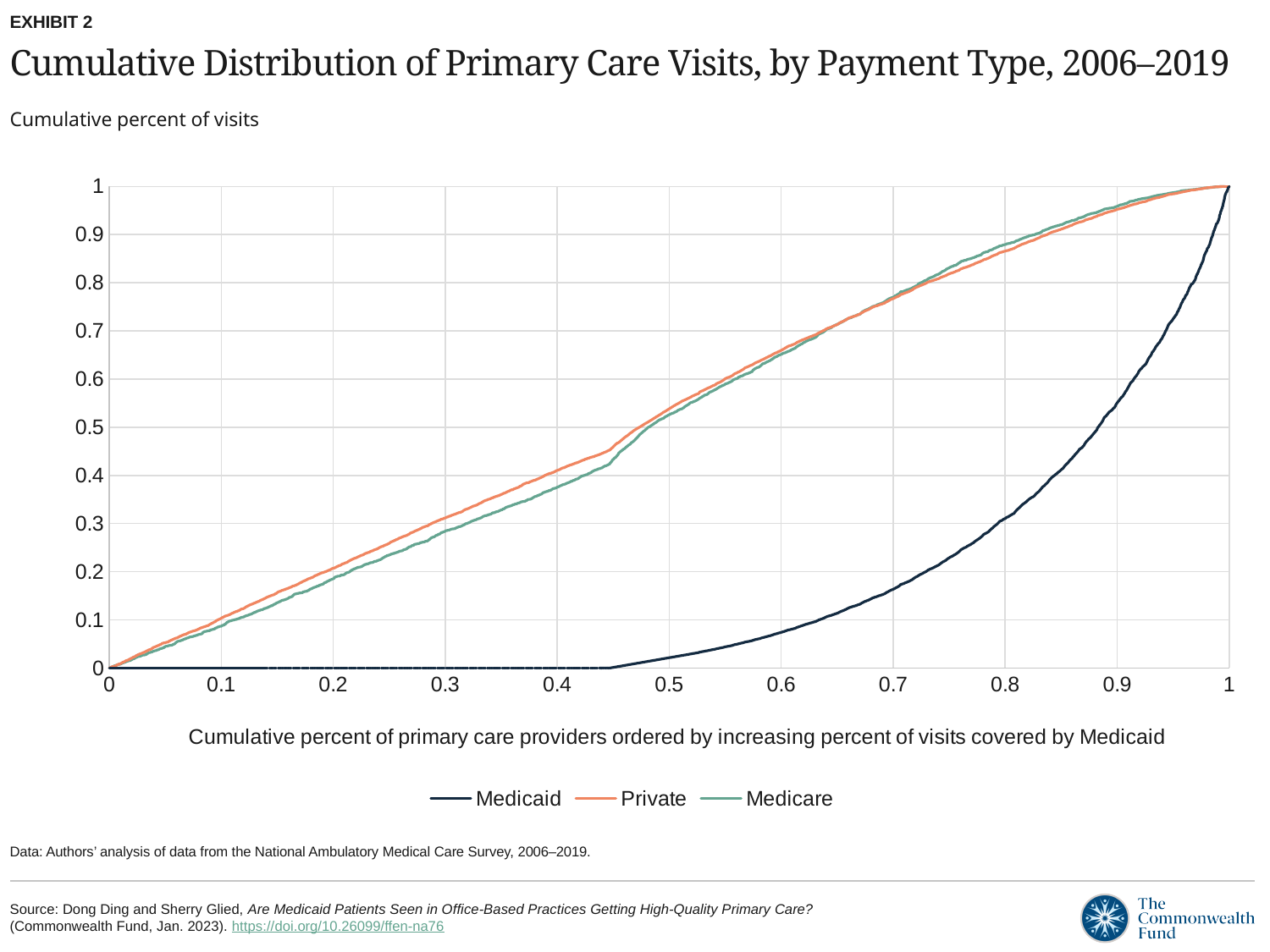
At x = 0.5, which series has the larger value, Private or Medicaid? Private What is the cumulative percent of visits for the Medicaid series at x = 1? 1 What is the cumulative percent of visits for the Medicaid series at x = 0.2? 0 At x = 0.4, which series has the larger value, Private or Medicare? Private Is the value of the Medicaid series at x = 0.7 greater or less than 0.2? less Which series are listed in the legend? Medicaid, Private, Medicare What kind of chart is shown on the slide? Line chart Is the value of the Private series at x = 0.7 greater or less than 0.7? greater Do the values of the Private series rise or fall as x increases from 0 to 1? Rise How many series does the legend list? 3 Is the value of the Medicaid series at x = 0.8 greater or less than 0.4? less What is the title of the chart? Cumulative Distribution of Primary Care Visits, by Payment Type, 2006–2019